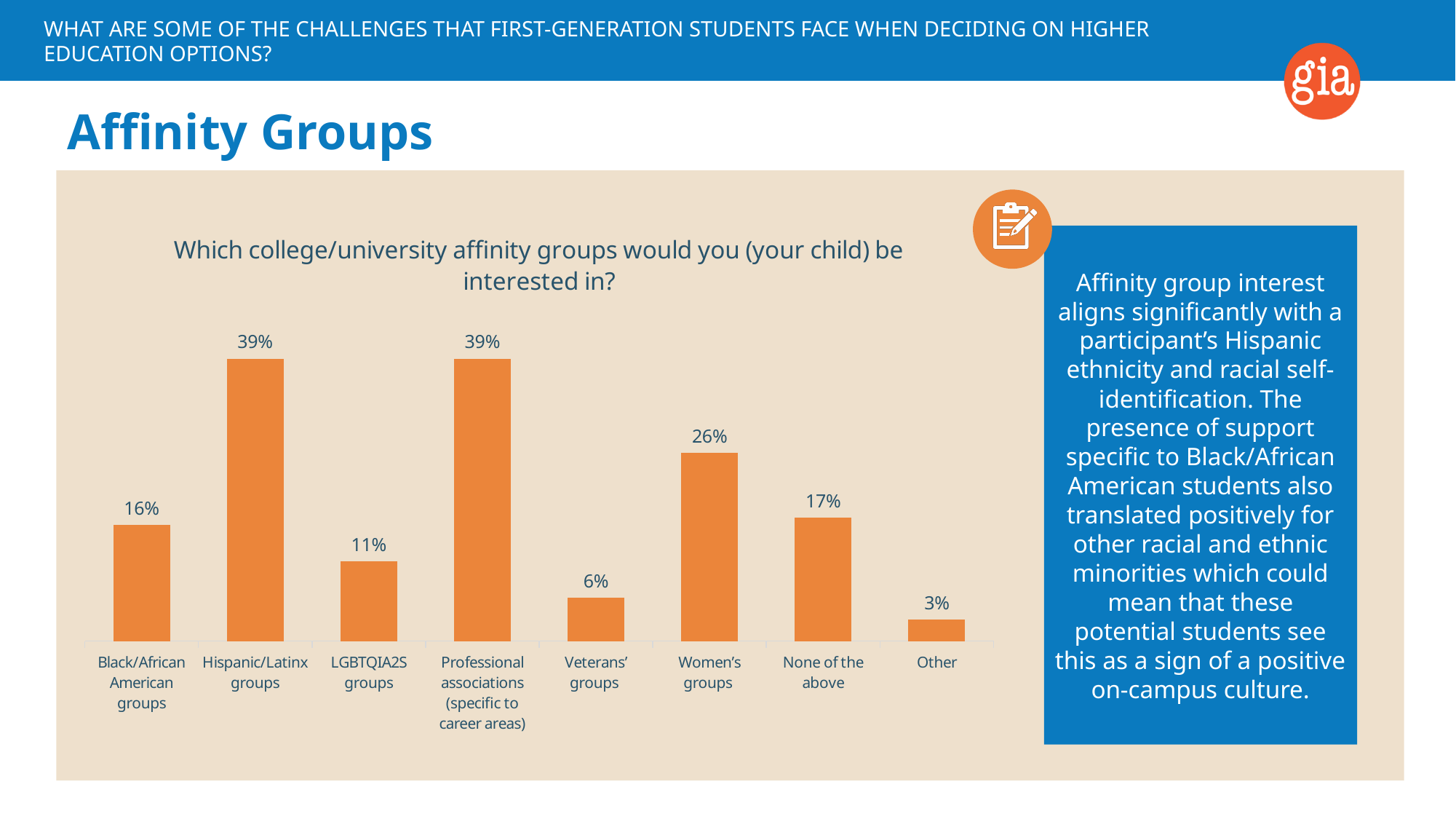
Which two categories share the highest value of 39%? Hispanic/Latinx groups and Professional associations (specific to career areas) What percentage is shown for Black/African American groups? 16% Which category has the lowest value in the chart? Other What is the title of the chart? Which college/university affinity groups would you (your child) be interested in? What is the value for Veterans' groups? 6% How many categories are shown in the chart? 8 What percentage of respondents would be interested in Women's groups? 26% What type of chart is shown on the slide? Bar chart What is the value shown for LGBTQIA2S groups? 11% What is the difference between the values for Hispanic/Latinx groups and Black/African American groups? 23% Which is larger, the value for LGBTQIA2S groups or the value for None of the above? None of the above What is the difference between the values for Women's groups and None of the above? 9%